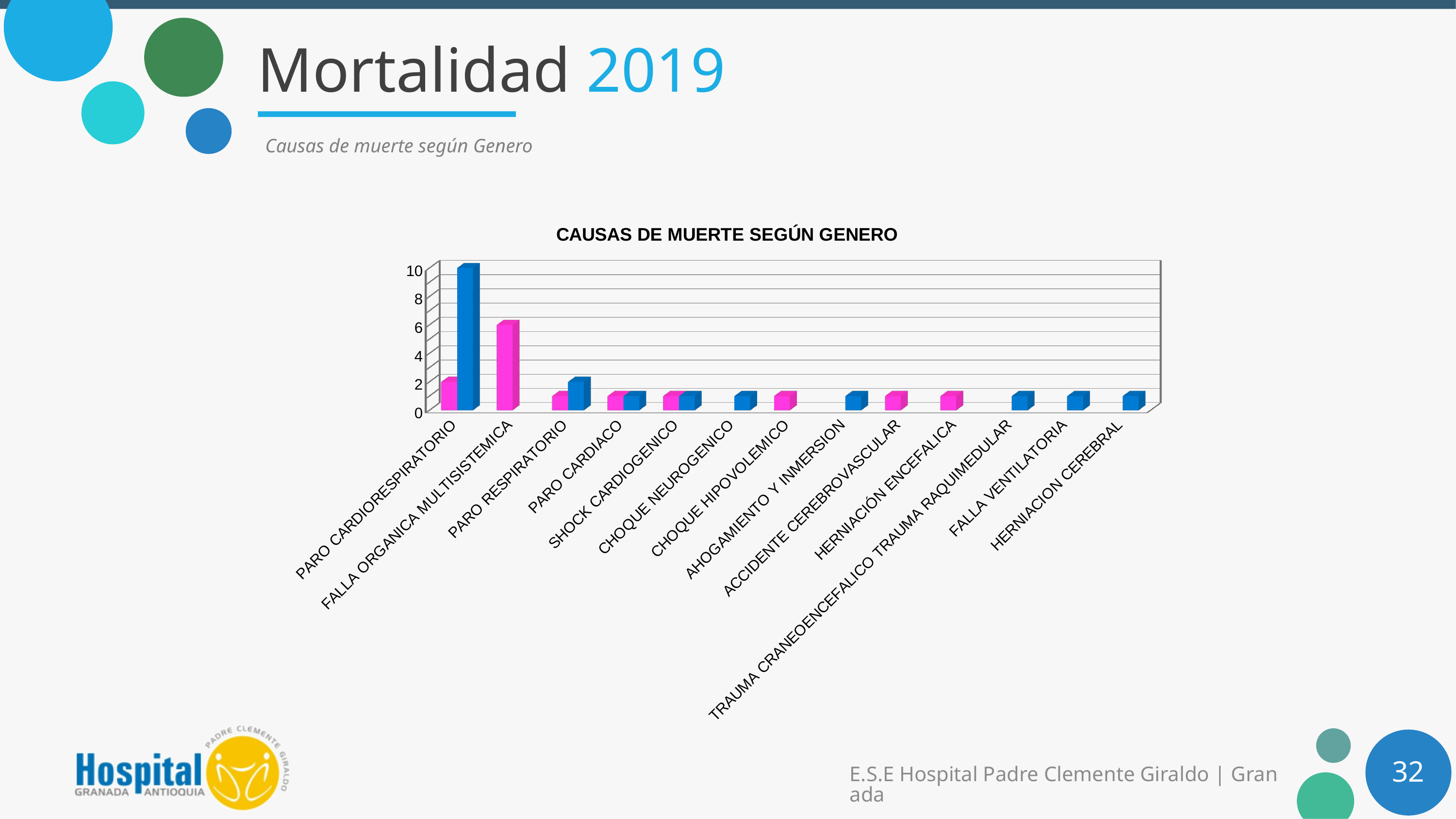
For PARO CARDIORESPIRATORIO, which bar is larger, the blue one or the pink one? the blue one Is the value of the pink bar for FALLA ORGANICA MULTISISTEMICA greater or less than 4? greater What kind of chart is shown on the slide? bar chart What is the value of the blue bar for PARO RESPIRATORIO? 2 What is the value of the pink bar for PARO CARDIORESPIRATORIO? 2 What is the value of the pink bar for FALLA ORGANICA MULTISISTEMICA? 6 Which category has the highest bar in the chart? PARO CARDIORESPIRATORIO How many causes of death (categories) are shown on the x axis of the chart? 13 Is the value of the blue bar for FALLA VENTILATORIA greater or less than 2? less What is the title of the chart? CAUSAS DE MUERTE SEGÚN GENERO What is the difference between the blue bar for PARO CARDIORESPIRATORIO and the pink bar for FALLA ORGANICA MULTISISTEMICA? 4 What is the value of the blue bar for PARO CARDIORESPIRATORIO? 10